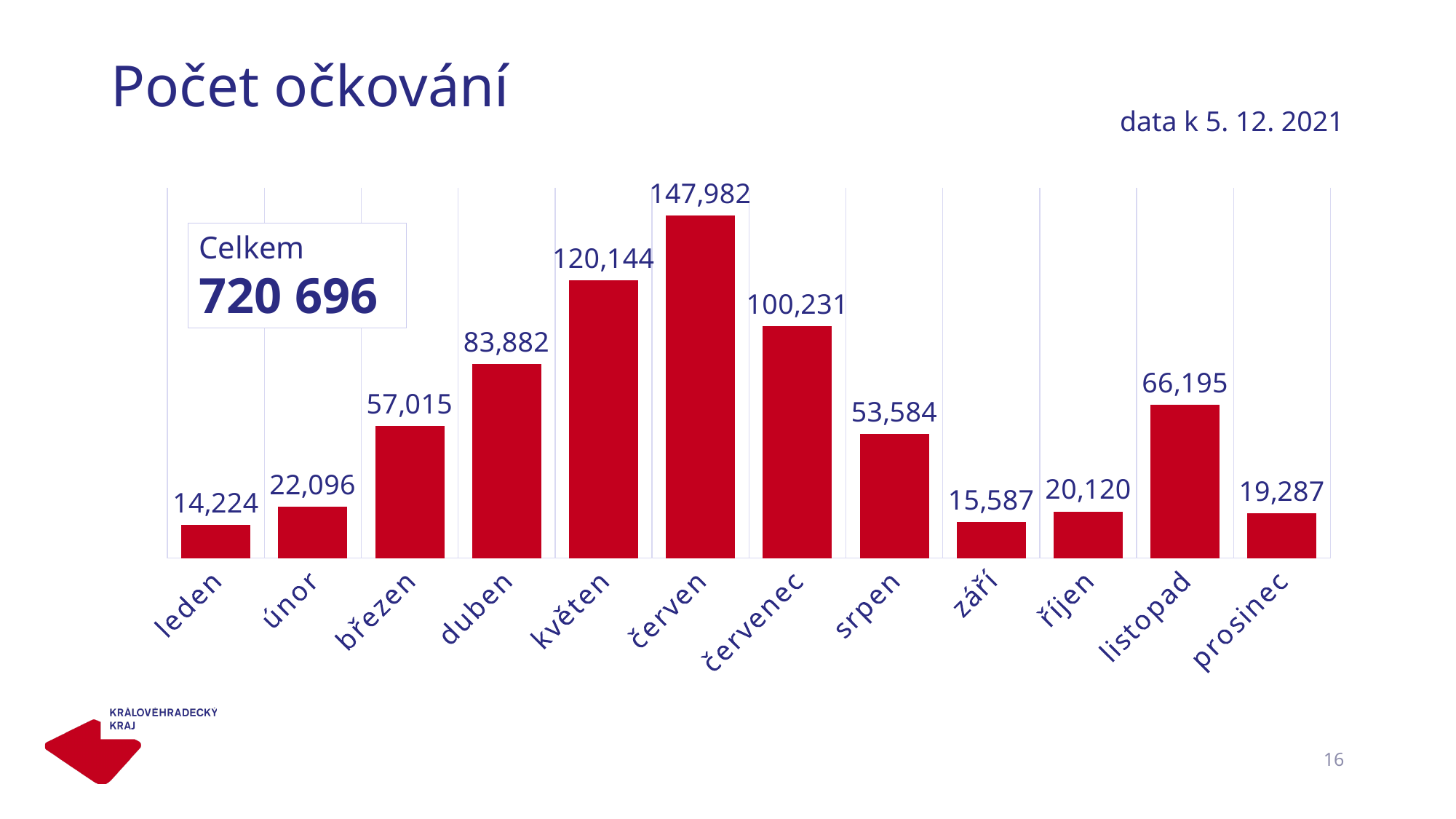
Which is larger, the value for duben or the value for srpen? duben What is the value for červen? 147,982 What is the value for září? 15,587 What is the value for listopad? 66,195 Do the values rise or fall from leden to červen? rise What total (Celkem) is shown in the box on the chart? 720 696 How many months are shown on the x axis? 12 What kind of chart is shown on the slide? bar chart What is the difference between the values for listopad and říjen? 46,075 What is the difference between the values for červen and květen? 27,838 Which month has the lowest value? leden Which month has the highest value? červen